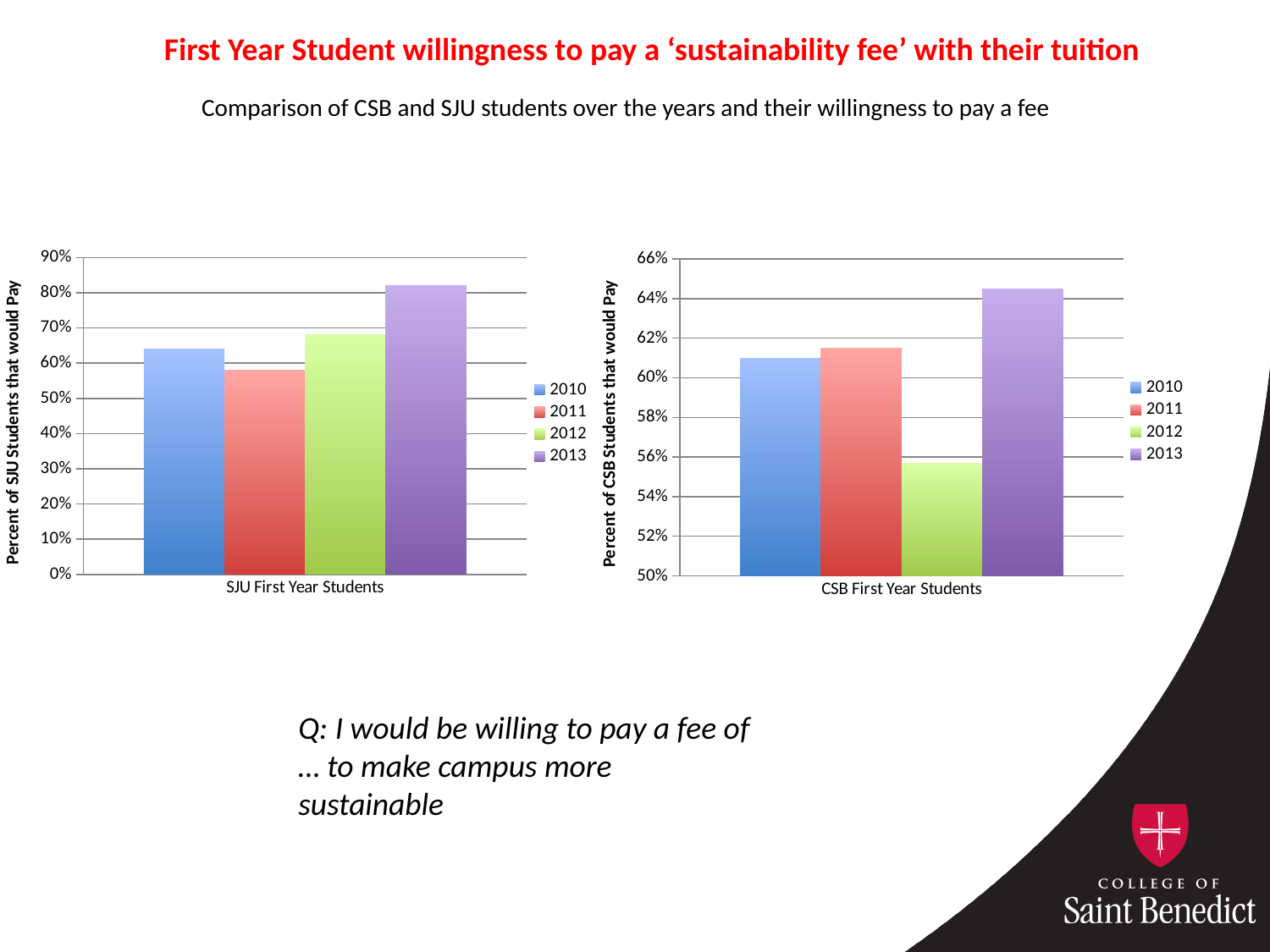
In the SJU First Year Students chart, is the value for 2011 greater or less than 60%? less In the SJU First Year Students chart, is the value for 2013 greater or less than 70%? greater In the SJU First Year Students chart, which is larger, the value for 2012 or the value for 2010? 2012 In the CSB First Year Students chart, is the value for 2013 greater or less than 62%? greater How many series does the legend of the SJU First Year Students chart list? 4 In the CSB First Year Students chart, which year has the lowest percentage of students that would pay? 2012 In the CSB First Year Students chart, which is larger, the value for 2013 or the value for 2010? 2013 In the SJU First Year Students chart, which year has the lowest percentage of students that would pay? 2011 What kind of chart is the CSB First Year Students chart? bar chart In the CSB First Year Students chart, which year has the highest percentage of students that would pay? 2013 In the SJU First Year Students chart, which year has the highest percentage of students that would pay? 2013